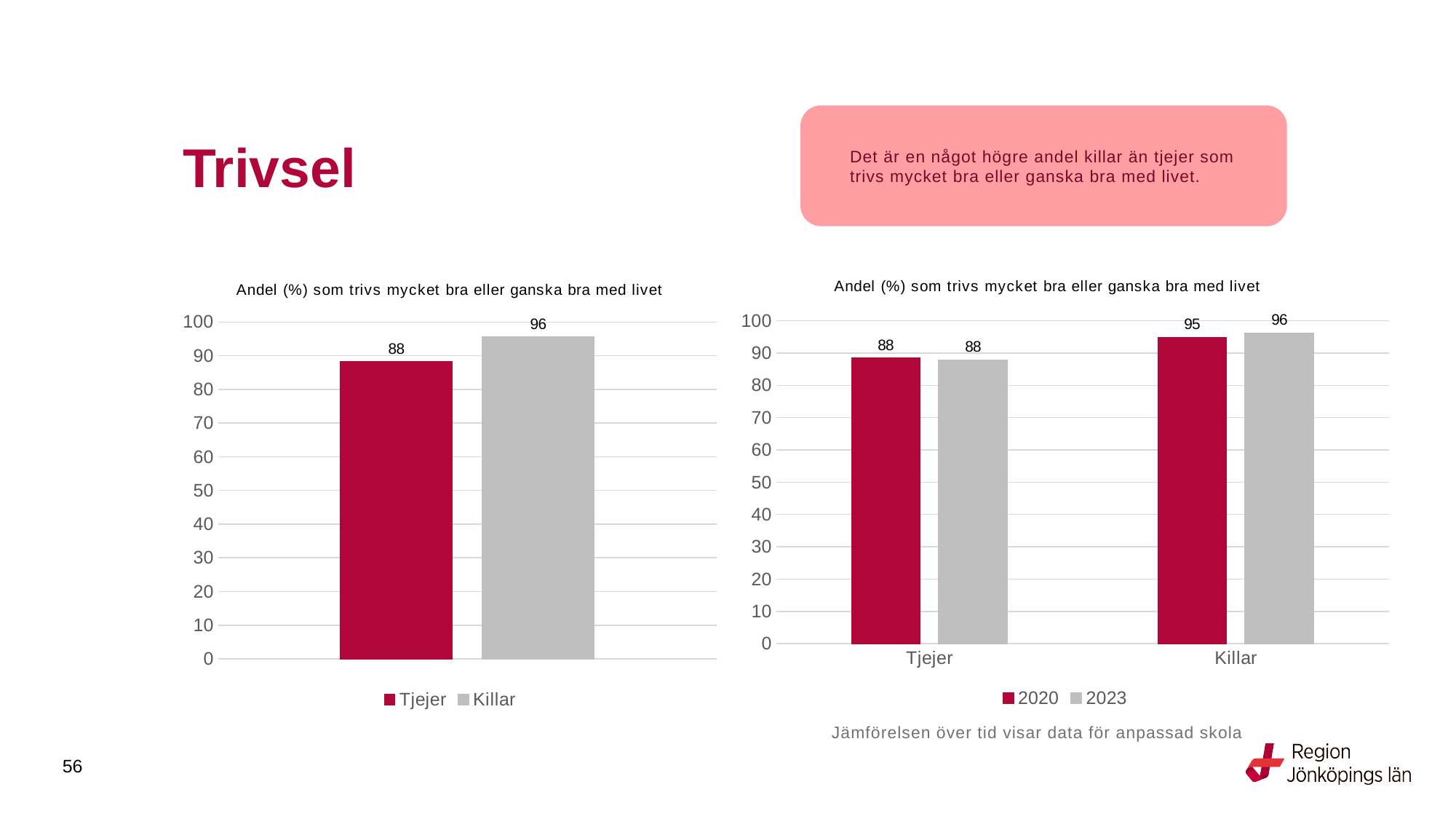
What is the title of the right chart? Andel (%) som trivs mycket bra eller ganska bra med livet In the right chart, what is the value for Killar in 2020? 95 In the right chart, what is the difference between the 2023 values for Killar and Tjejer? 8 In the right chart, how many series does the legend list? 2 In the right chart, what is the value for Killar in 2023? 96 In the left chart, what is the value for Tjejer? 88 In the right chart, what is the value for Tjejer in 2023? 88 In the left chart, what is the value for Killar? 96 What kind of chart is the left chart? Bar chart In the left chart, what is the difference between the values for Killar and Tjejer? 8 In the right chart, how many categories are shown on the x axis? 2 In the left chart, which group has the higher value, Tjejer or Killar? Killar